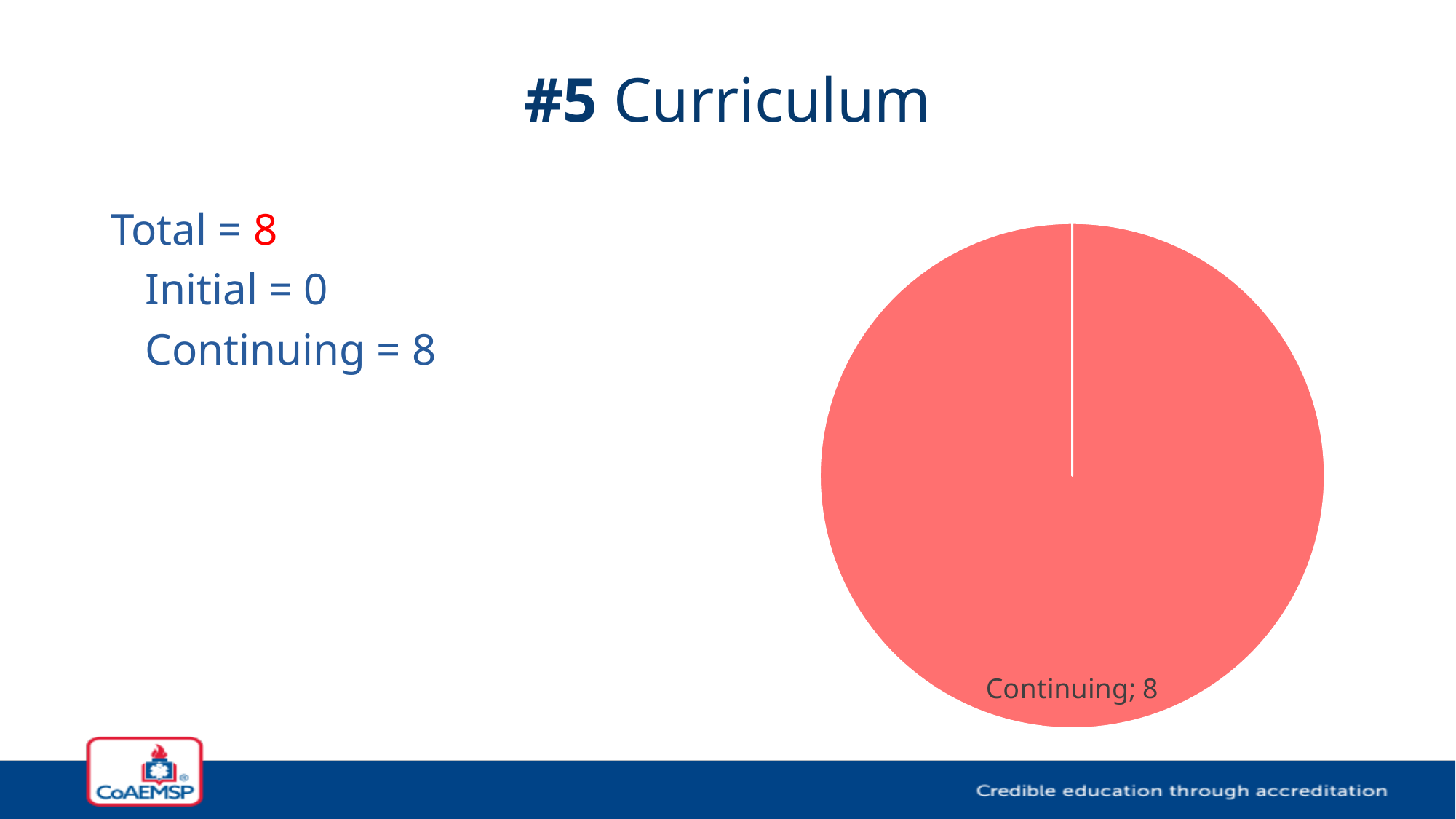
Which category is the largest slice of the pie chart? Continuing How many labeled slices does the pie chart show? 1 What colour is the Continuing slice of the pie chart? red What is the title of the slide containing the pie chart? #5 Curriculum What value is shown for the Continuing slice of the pie chart? 8 What share of the pie does the Continuing slice represent? 100% Is the value for Continuing in the pie chart greater or less than 5? greater What kind of chart is shown on the slide? pie chart